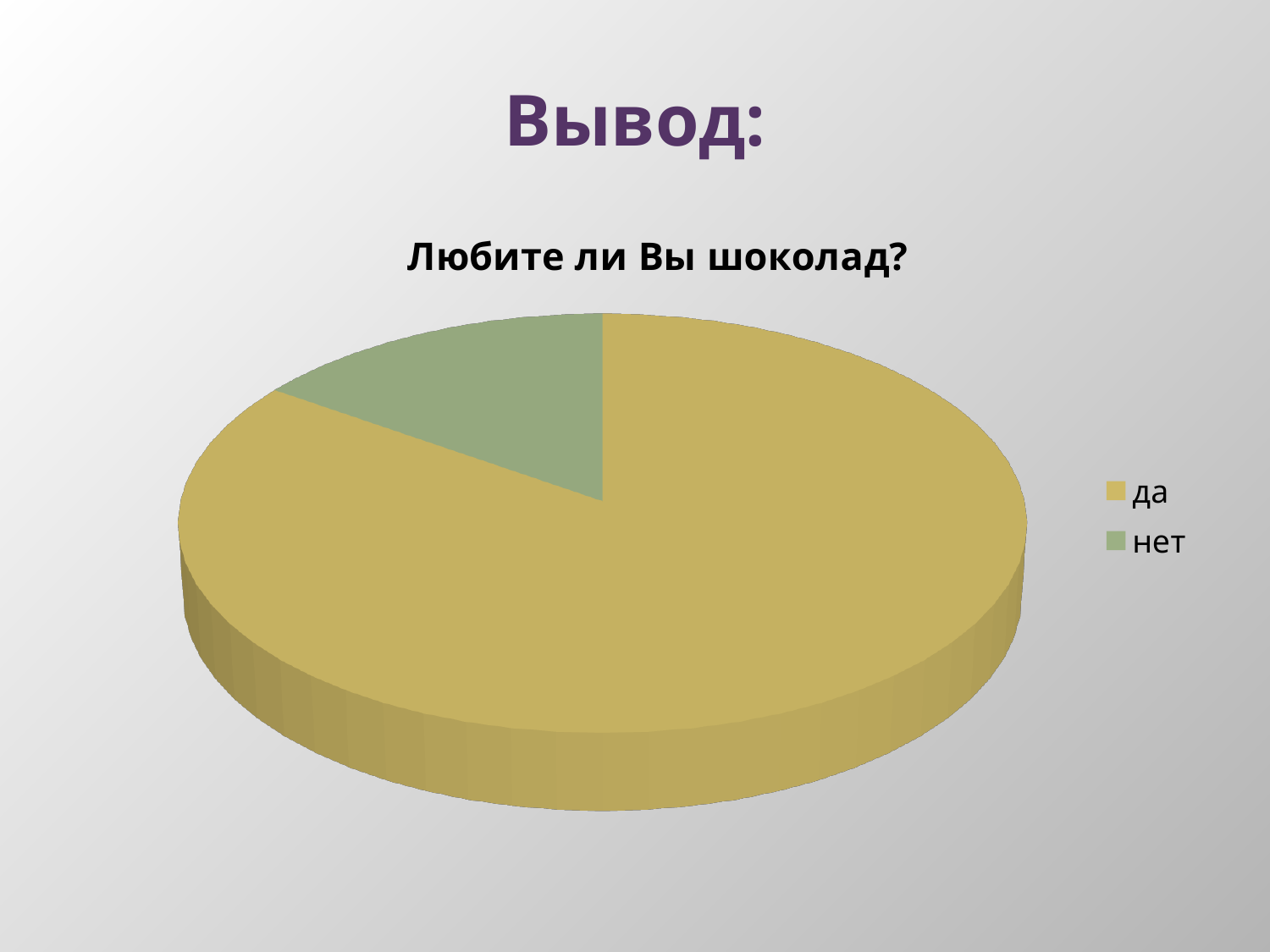
What colour is the slice for "нет"? green How many slices does the pie chart have? 2 Which slice is larger, "да" or "нет"? да What kind of chart is shown on the slide? pie chart What is the title of the chart? Любите ли Вы шоколад? Is the share of "да" greater or less than 50%? greater Which category has the smallest slice of the pie? нет How many entries does the legend list? 2 Is the share of "нет" greater or less than 50%? less Which category has the largest slice of the pie? да